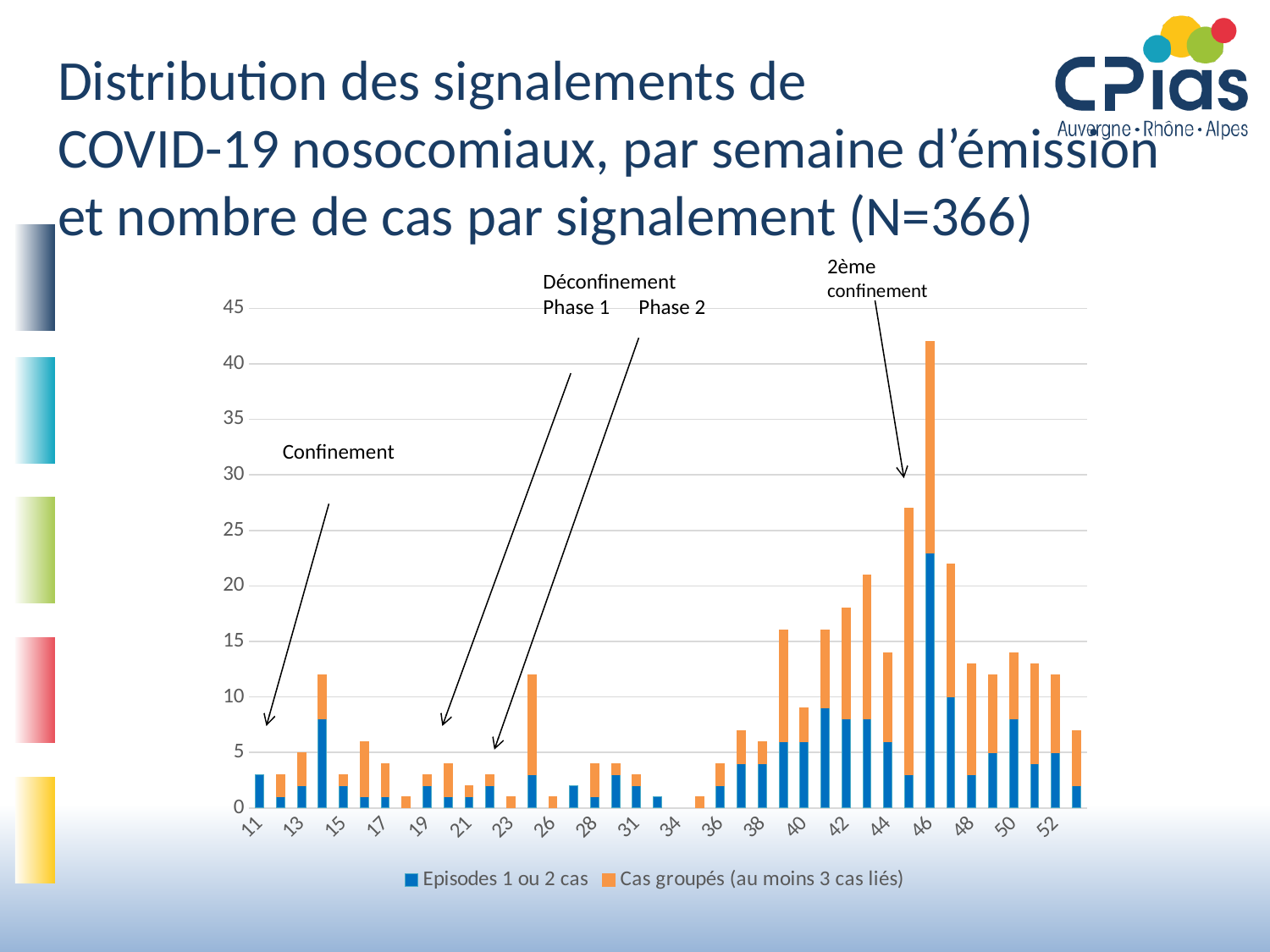
Which week has the larger total, week 40 or week 42? 42 What event does the annotation pointing to week 45 indicate? 2ème confinement Which week has the larger total, week 13 or week 15? 13 What kind of chart is shown on the slide? Stacked bar chart How many series does the legend list? 2 Which week has the highest total number of signalements? 46 Which series is shown in orange in the legend? Cas groupés (au moins 3 cas liés) Is the total value for week 44 greater or less than 10? greater Is the total value for week 46 greater or less than 35? greater Is the total value for week 11 greater or less than 5? less Do the total values generally rise or fall from week 36 to week 46? rise